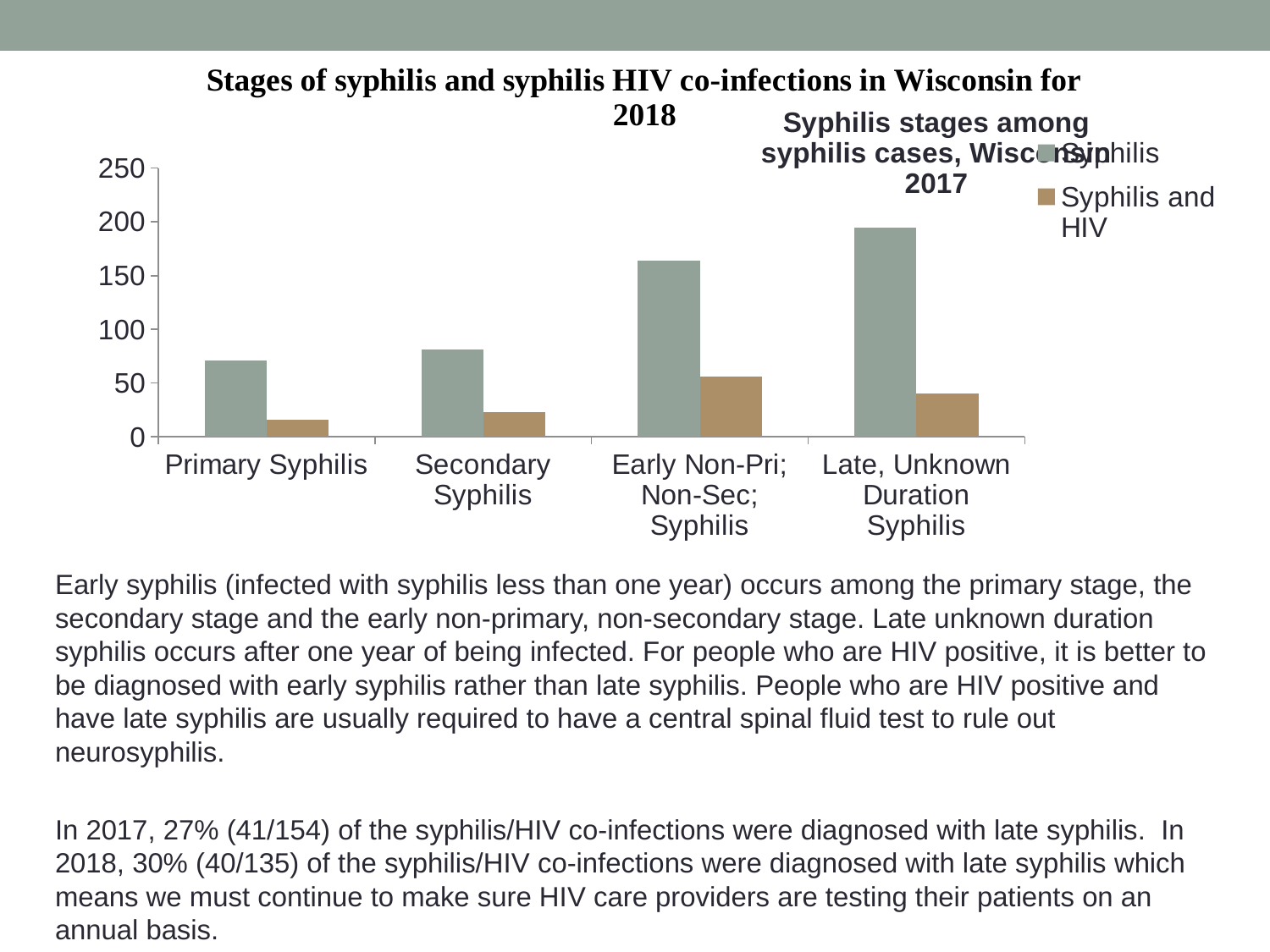
Is the Syphilis value for Early Non-Pri; Non-Sec; Syphilis greater or less than 150? greater How many syphilis stage categories are shown on the x axis of the chart? 4 What kind of chart is shown on the slide? Bar chart Which is larger: the Syphilis and HIV value for Early Non-Pri; Non-Sec; Syphilis or for Late, Unknown Duration Syphilis? Early Non-Pri; Non-Sec; Syphilis How many series does the chart's legend list? 2 Which category has the lowest value for the Syphilis series? Primary Syphilis Which category has the highest value for the Syphilis series? Late, Unknown Duration Syphilis Do the values for the Syphilis series rise or fall moving from Primary Syphilis to Late, Unknown Duration Syphilis along the x axis? Rise Is the Syphilis and HIV value for Secondary Syphilis greater or less than 50? less Which category has the lowest value for the Syphilis and HIV series? Primary Syphilis Which category has the highest value for the Syphilis and HIV series? Early Non-Pri; Non-Sec; Syphilis